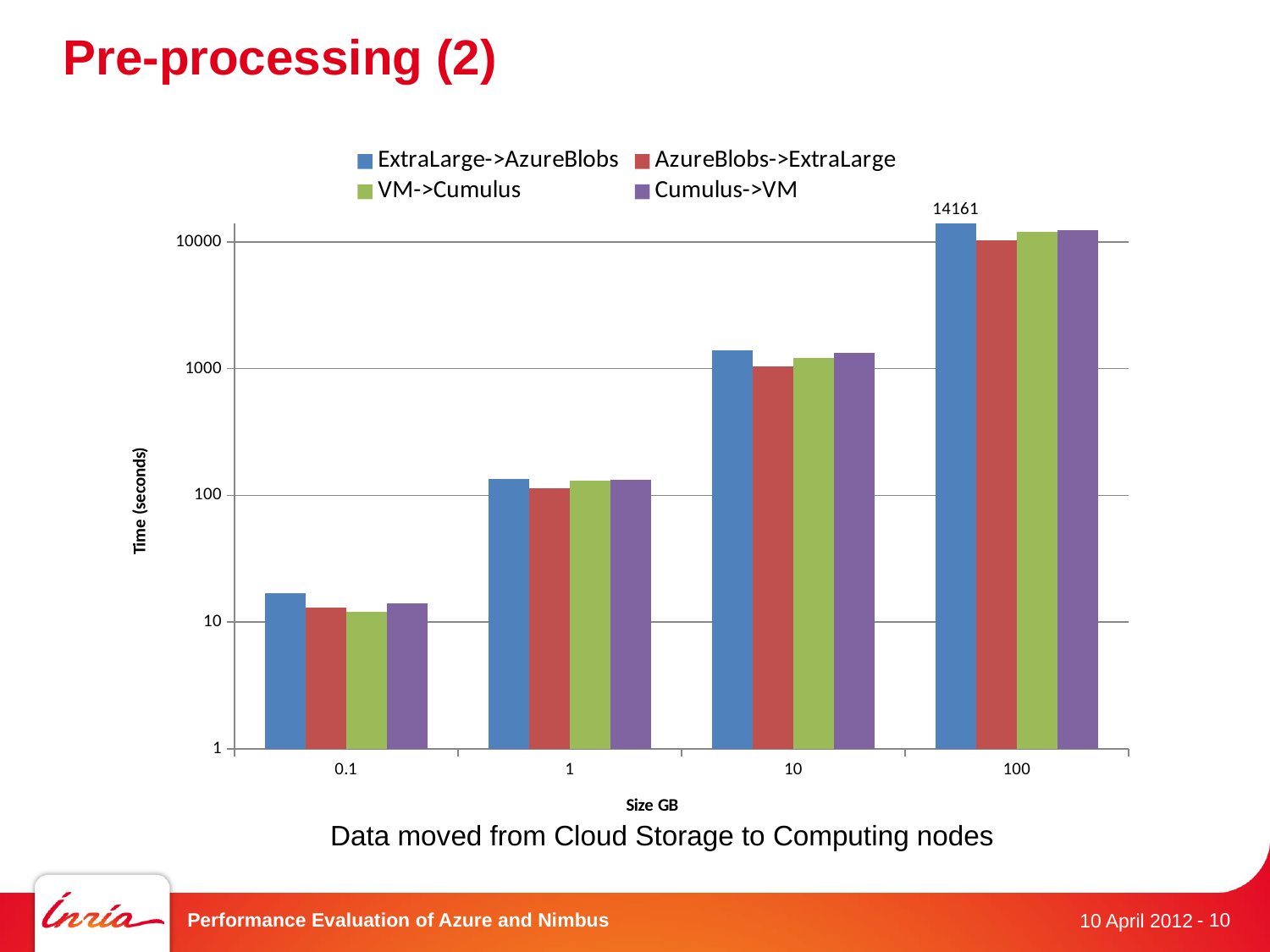
Do the values for ExtraLarge->AzureBlobs rise or fall as the size increases along the x axis? rise What is the title of the y axis? Time (seconds) What kind of chart is shown on the slide? bar chart Which series has the lowest value at 100 GB? AzureBlobs->ExtraLarge Which series has the highest value at 100 GB? ExtraLarge->AzureBlobs How many size categories are shown on the x axis? 4 Is the value for Cumulus->VM at 0.1 GB greater or less than 100? less Is the value for ExtraLarge->AzureBlobs at 10 GB greater or less than 1000? greater At 10 GB, which is larger: ExtraLarge->AzureBlobs or AzureBlobs->ExtraLarge? ExtraLarge->AzureBlobs What is the value for ExtraLarge->AzureBlobs at 100 GB? 14161 Is the value for AzureBlobs->ExtraLarge at 1 GB greater or less than 1000? less How many series does the legend list? 4